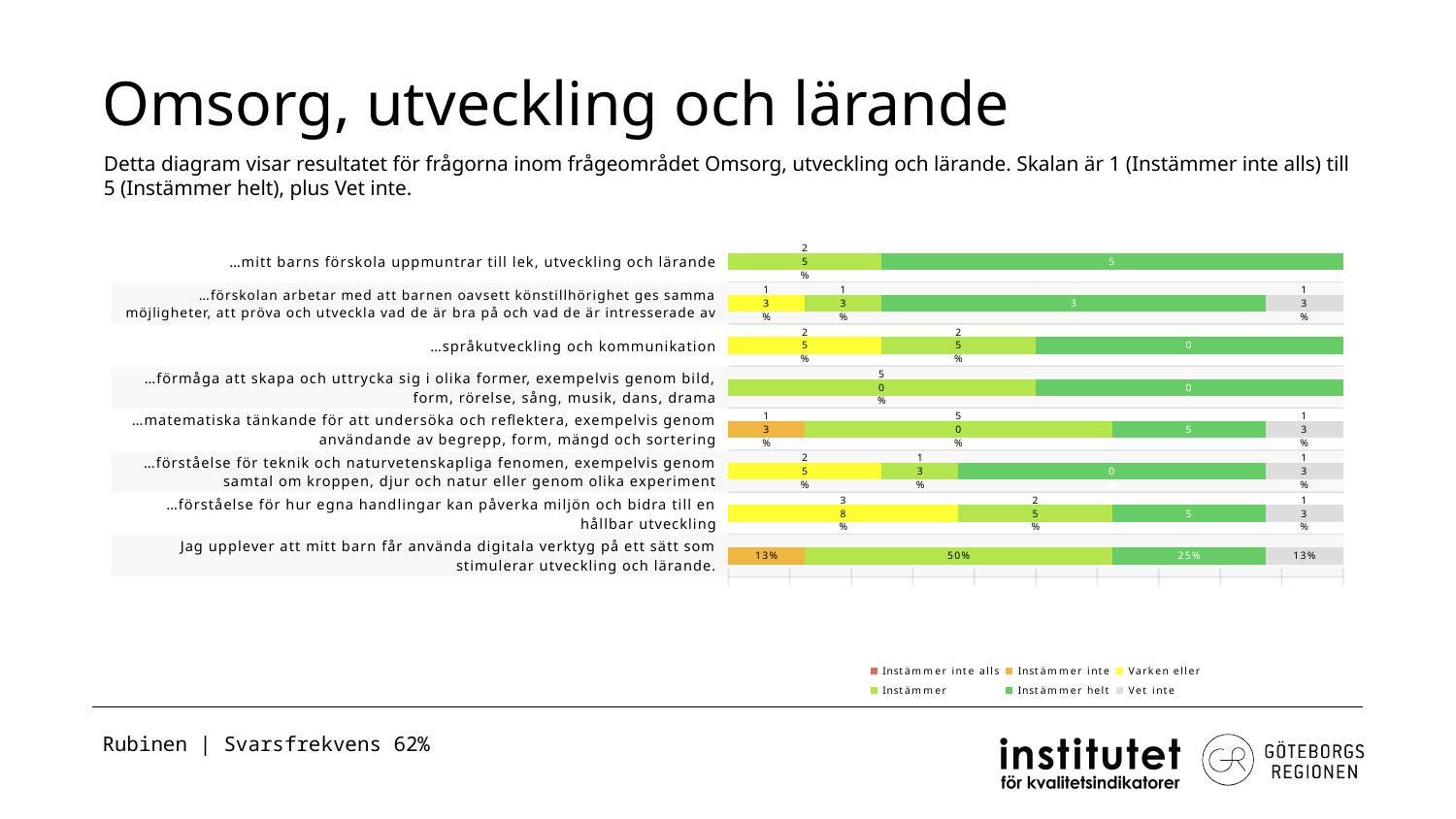
What response rate (Svarsfrekvens) is stated at the bottom of the slide? 62% What kind of chart is shown on the slide? Stacked bar chart In the row 'Jag upplever att mitt barn får använda digitala verktyg...', which response category has the largest share? Instämmer What is the value for 'Instämmer inte' in the row 'Jag upplever att mitt barn får använda digitala verktyg på ett sätt som stimulerar utveckling och lärande.'? 13% In the row 'Jag upplever att mitt barn får använda digitala verktyg...', what is the difference between 'Instämmer' and 'Instämmer helt'? 25% What is the value for 'Instämmer helt' in the row 'Jag upplever att mitt barn får använda digitala verktyg på ett sätt som stimulerar utveckling och lärande.'? 25% How many series does the legend list? 6 How many question statements (categories) are plotted in the chart? 8 Which legend entry is shown in grey? Vet inte In the row 'Jag upplever att mitt barn får använda digitala verktyg...', which is larger: 'Instämmer' or 'Instämmer helt'? Instämmer What is the value for 'Instämmer' in the row 'Jag upplever att mitt barn får använda digitala verktyg på ett sätt som stimulerar utveckling och lärande.'? 50% What is the value for 'Vet inte' in the row 'Jag upplever att mitt barn får använda digitala verktyg på ett sätt som stimulerar utveckling och lärande.'? 13%